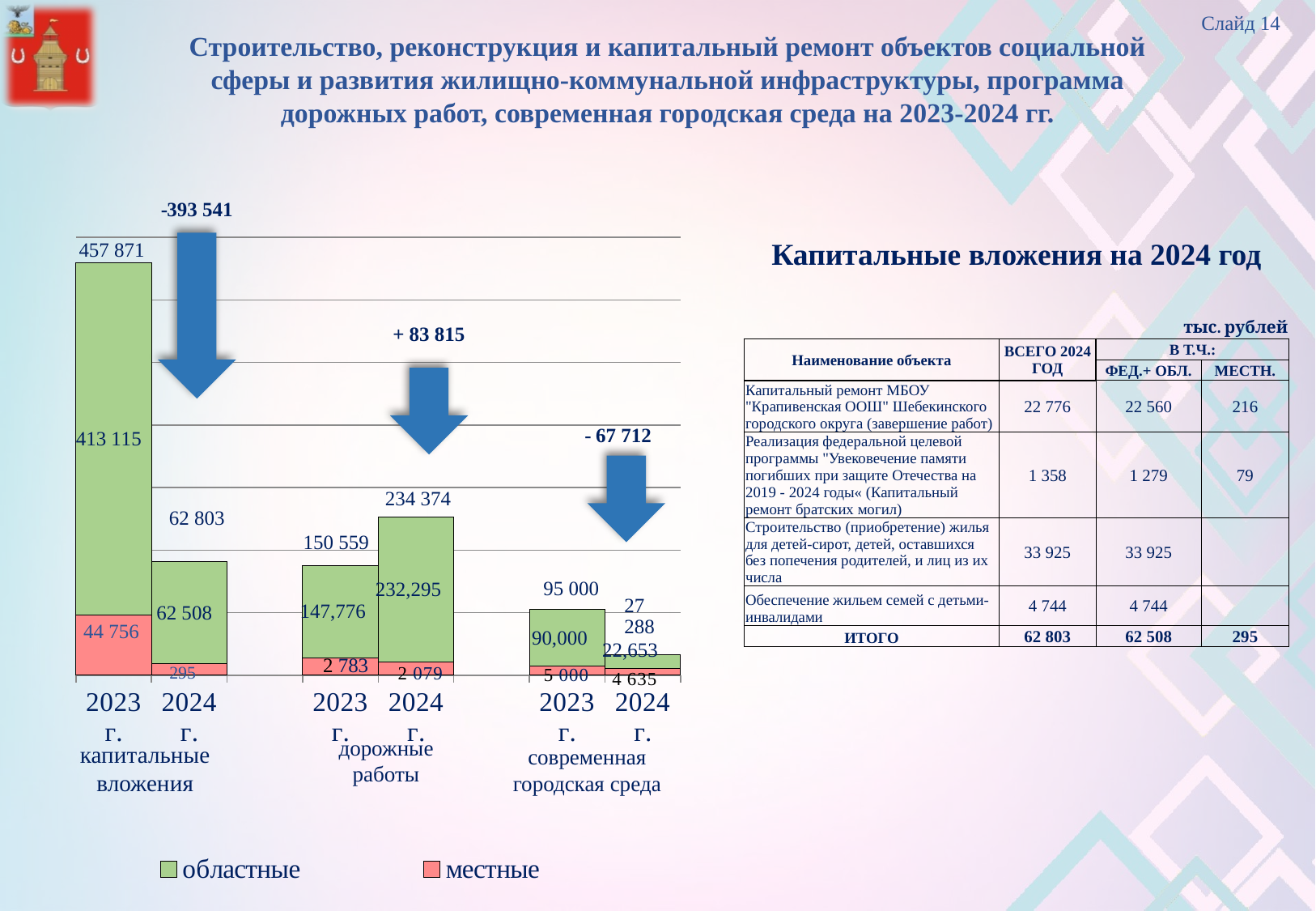
What is the областные value for дорожные работы in 2024? 232,295 What is the местные value for капитальные вложения in 2023? 44 756 What is the областные value for капитальные вложения in 2023? 413 115 How many series does the chart legend list? 2 What is the total for дорожные работы in 2023? 150 559 What kind of chart is shown on the left of the slide? stacked bar chart What is the местные value for современная городская среда in 2023? 5 000 Which is larger: the total for дорожные работы in 2024 or the total for современная городская среда in 2023? дорожные работы 2024 What is the total for капитальные вложения in 2024? 62 803 Which bar has the highest total in the chart? капитальные вложения 2023 What are the two series named in the chart legend? областные, местные What change is shown by the arrow above the капитальные вложения bars? -393 541